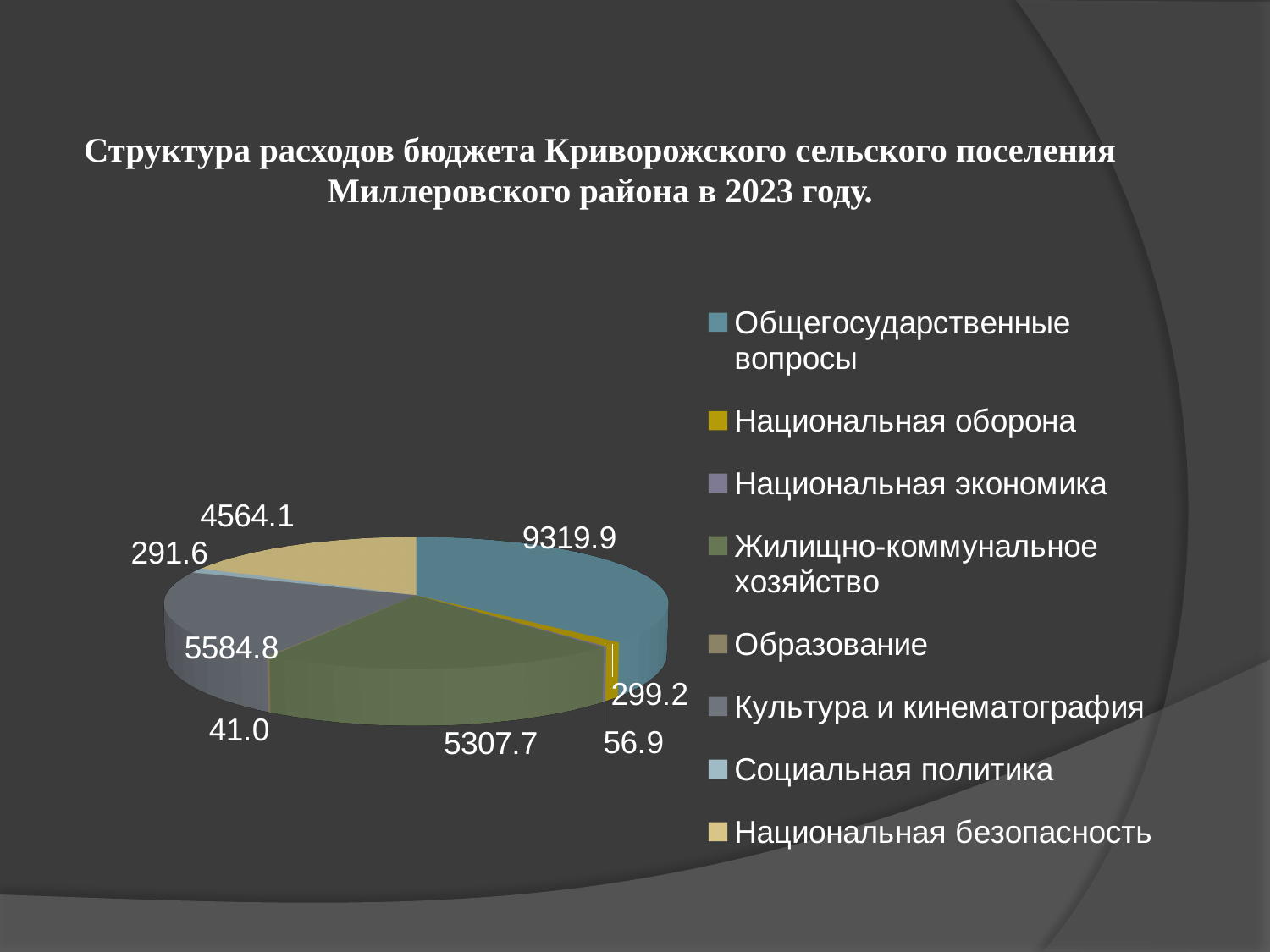
What is the smallest value labelled on the pie chart? 41.0 What kind of chart is shown on the slide? pie chart What is the difference between the value for Общегосударственные вопросы and the value for Культура и кинематография? 3735.1 How many categories does the legend of the pie chart list? 8 Which category has the largest slice of the pie? Общегосударственные вопросы What is the value labelled on the slice for Общегосударственные вопросы? 9319.9 Which year does the chart title say the budget expenditure structure refers to? 2023 Which is larger, the value for Культура и кинематография or the value for Жилищно-коммунальное хозяйство? Культура и кинематография What is the difference between the value for Культура и кинематография and the value for Жилищно-коммунальное хозяйство? 277.1 What is the value labelled on the slice for Национальная безопасность? 4564.1 What is the value labelled on the slice for Культура и кинематография? 5584.8 What is the value labelled on the slice for Жилищно-коммунальное хозяйство? 5307.7